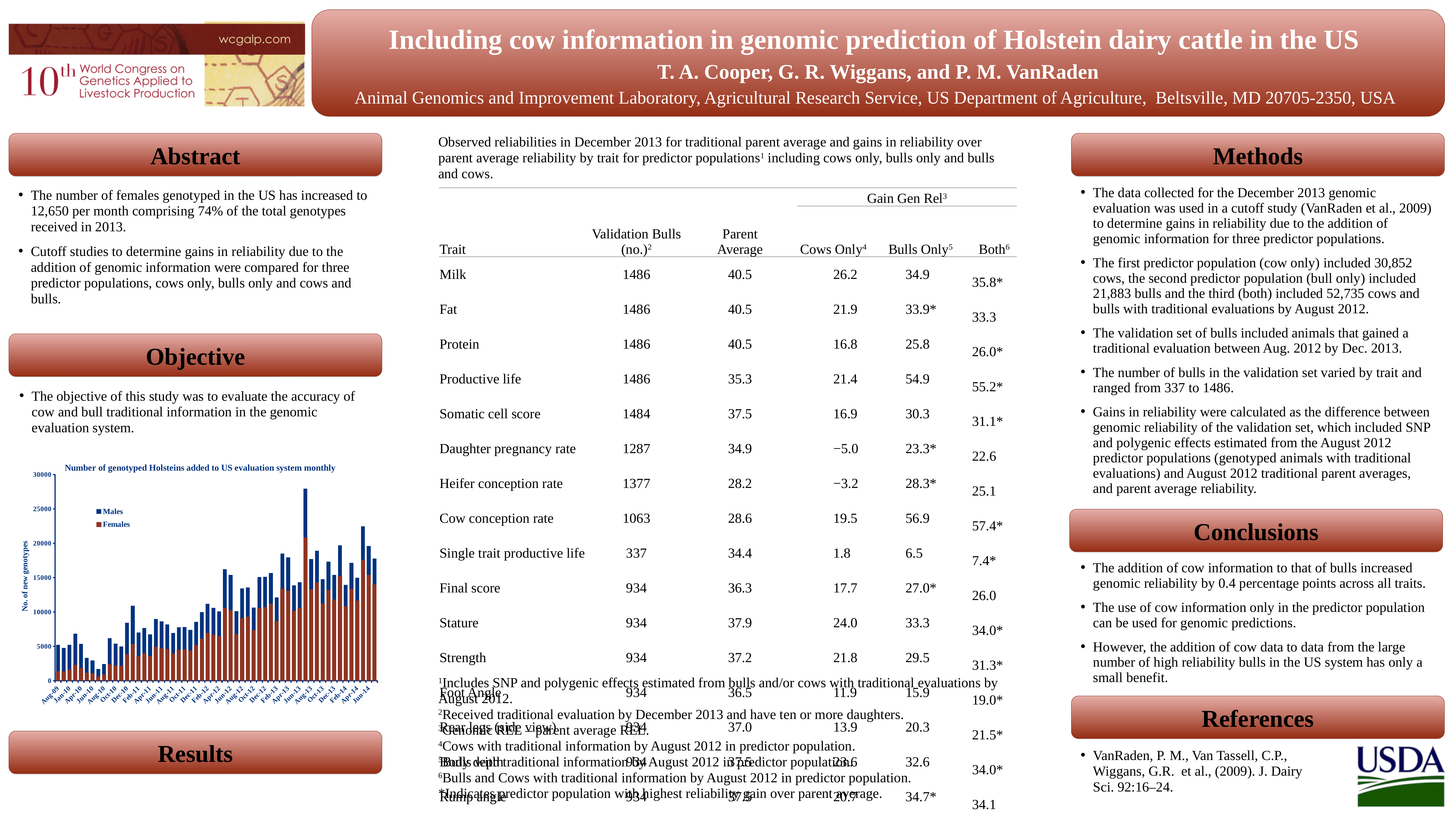
Which has a larger total number of new genotypes, Aug-09 or Aug-13? Aug-13 How many series does the chart legend list? 2 Which series is shown in dark red in the chart? Females Is the total number of new genotypes for Aug-09 greater or less than 10000? less What kind of chart is shown on the slide? Stacked bar chart Is the total number of new genotypes for Jun-14 greater or less than 15000? greater Overall, do the monthly totals of new genotypes rise or fall from Aug-09 to Jun-14? rise What is the title of the chart? Number of genotyped Holsteins added to US evaluation system monthly What is the label of the y axis of the chart? No. of new genotypes Is the total number of new genotypes for Aug-13 greater or less than 25000? less